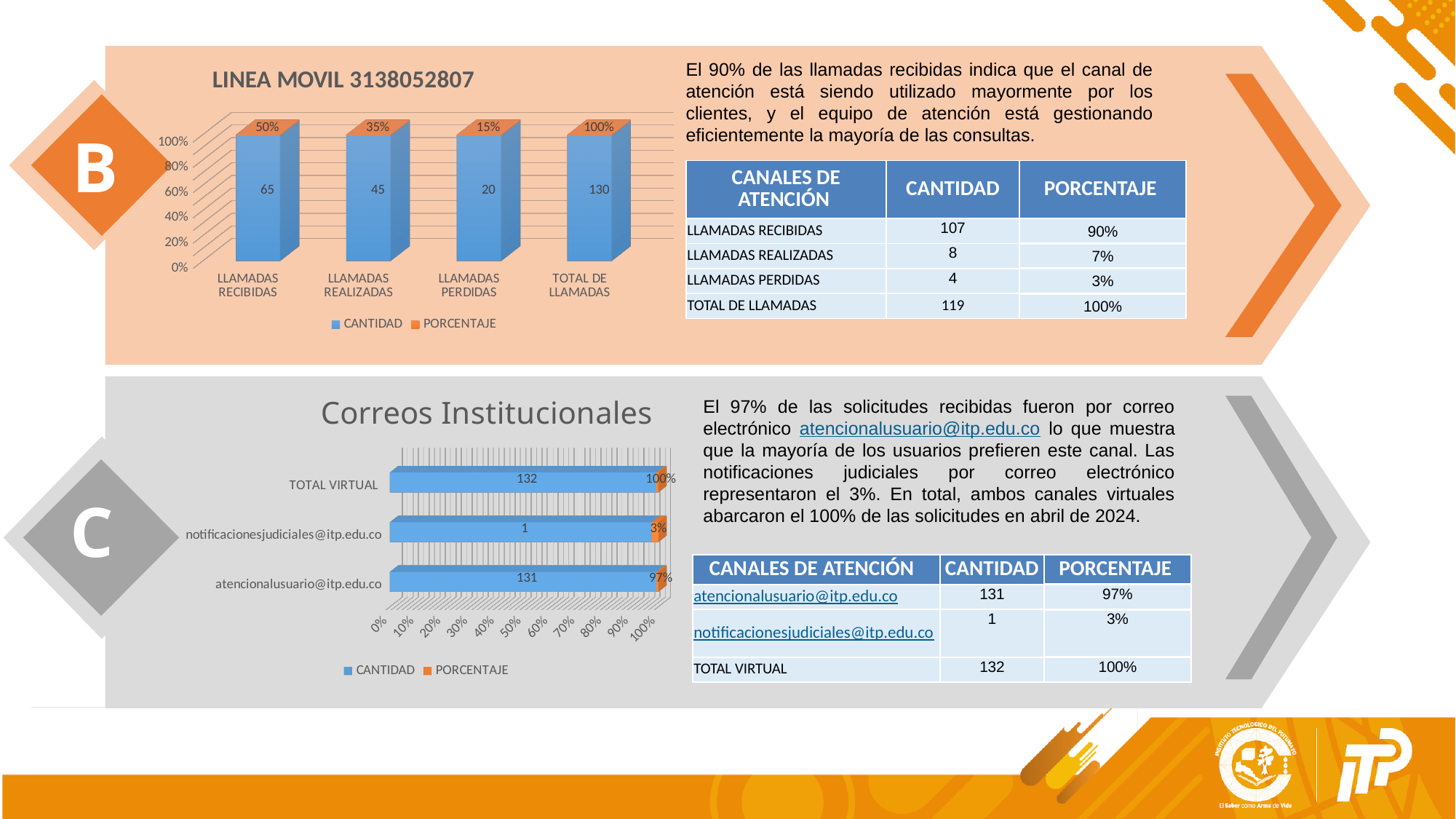
What kind of chart is the 'Correos Institucionales' chart? Bar chart In the 'Correos Institucionales' chart, what is the CANTIDAD value labelled for atencionalusuario@itp.edu.co? 131 How many series does the legend of the 'LINEA MOVIL 3138052807' chart list? 2 In the 'LINEA MOVIL 3138052807' chart, what PORCENTAJE is labelled for LLAMADAS REALIZADAS? 35% In the 'Correos Institucionales' chart, which has a larger CANTIDAD label: atencionalusuario@itp.edu.co or notificacionesjudiciales@itp.edu.co? atencionalusuario@itp.edu.co How many categories are shown on the x axis of the 'LINEA MOVIL 3138052807' chart? 4 In the 'LINEA MOVIL 3138052807' chart, what is the CANTIDAD value labelled for LLAMADAS PERDIDAS? 20 In the 'Correos Institucionales' chart, which category has the highest CANTIDAD label? TOTAL VIRTUAL In the 'LINEA MOVIL 3138052807' chart, what is the CANTIDAD value labelled for LLAMADAS RECIBIDAS? 65 In the 'LINEA MOVIL 3138052807' chart, which category has the lowest CANTIDAD label? LLAMADAS PERDIDAS In the 'LINEA MOVIL 3138052807' chart, what is the difference between the CANTIDAD labels for LLAMADAS RECIBIDAS and LLAMADAS REALIZADAS? 20 In the 'Correos Institucionales' chart, what PORCENTAJE is labelled for notificacionesjudiciales@itp.edu.co? 3%